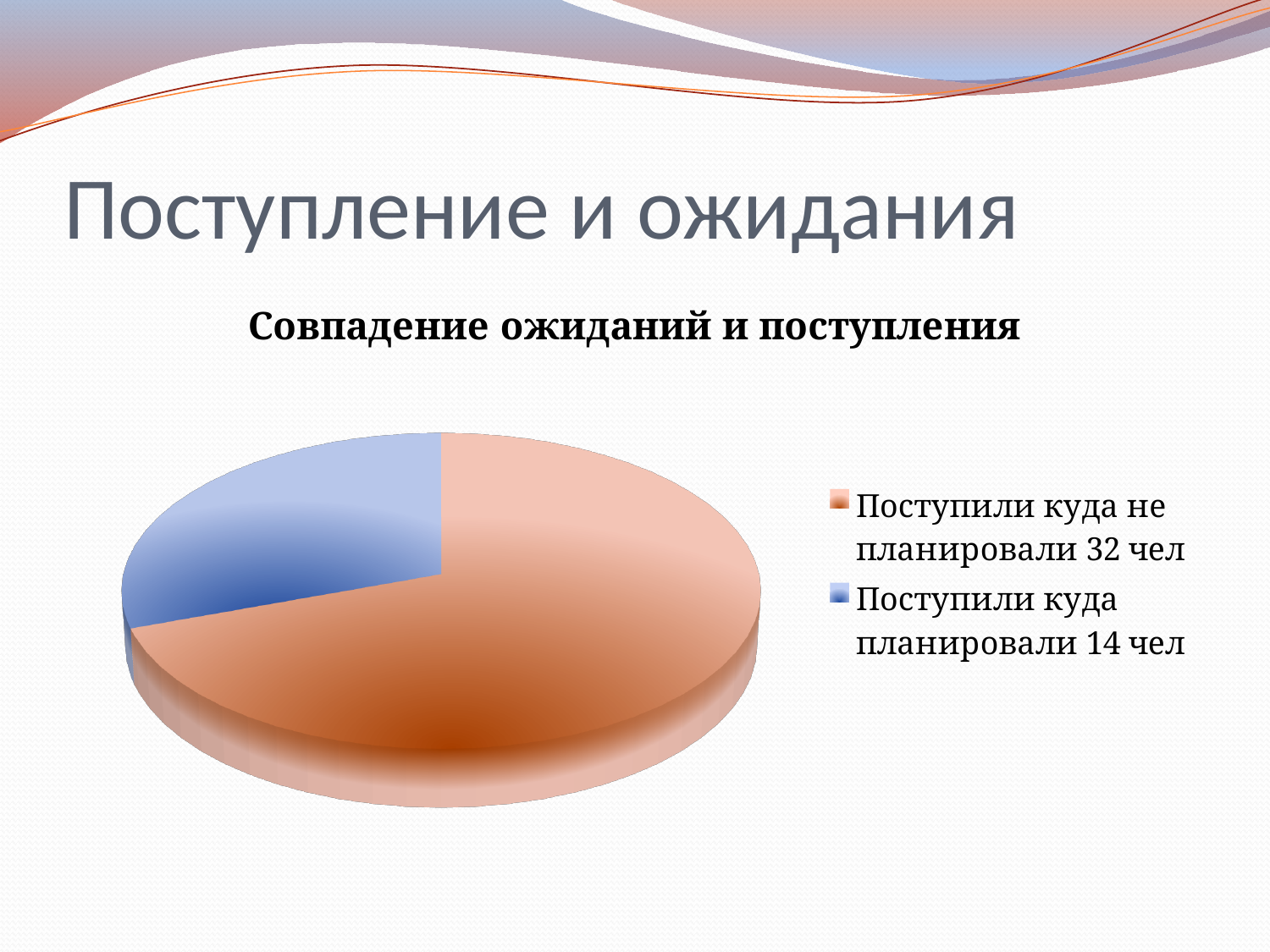
How many people are in the category "Поступили куда планировали"? 14 чел What is the total number of people represented in the pie chart? 46 чел What kind of chart is shown on the slide? pie chart Which is larger: the number who entered where they planned or the number who entered where they did not plan? Поступили куда не планировали How many entries does the legend list? 2 Which category has the smallest slice of the pie? Поступили куда планировали Which category has the largest slice of the pie? Поступили куда не планировали What is the difference between the number who entered where they did not plan and the number who entered where they planned? 18 чел What is the title of the chart? Совпадение ожиданий и поступления What colour is the slice for "Поступили куда планировали"? blue How many people are in the category "Поступили куда не планировали"? 32 чел How many slices does the pie chart have? 2